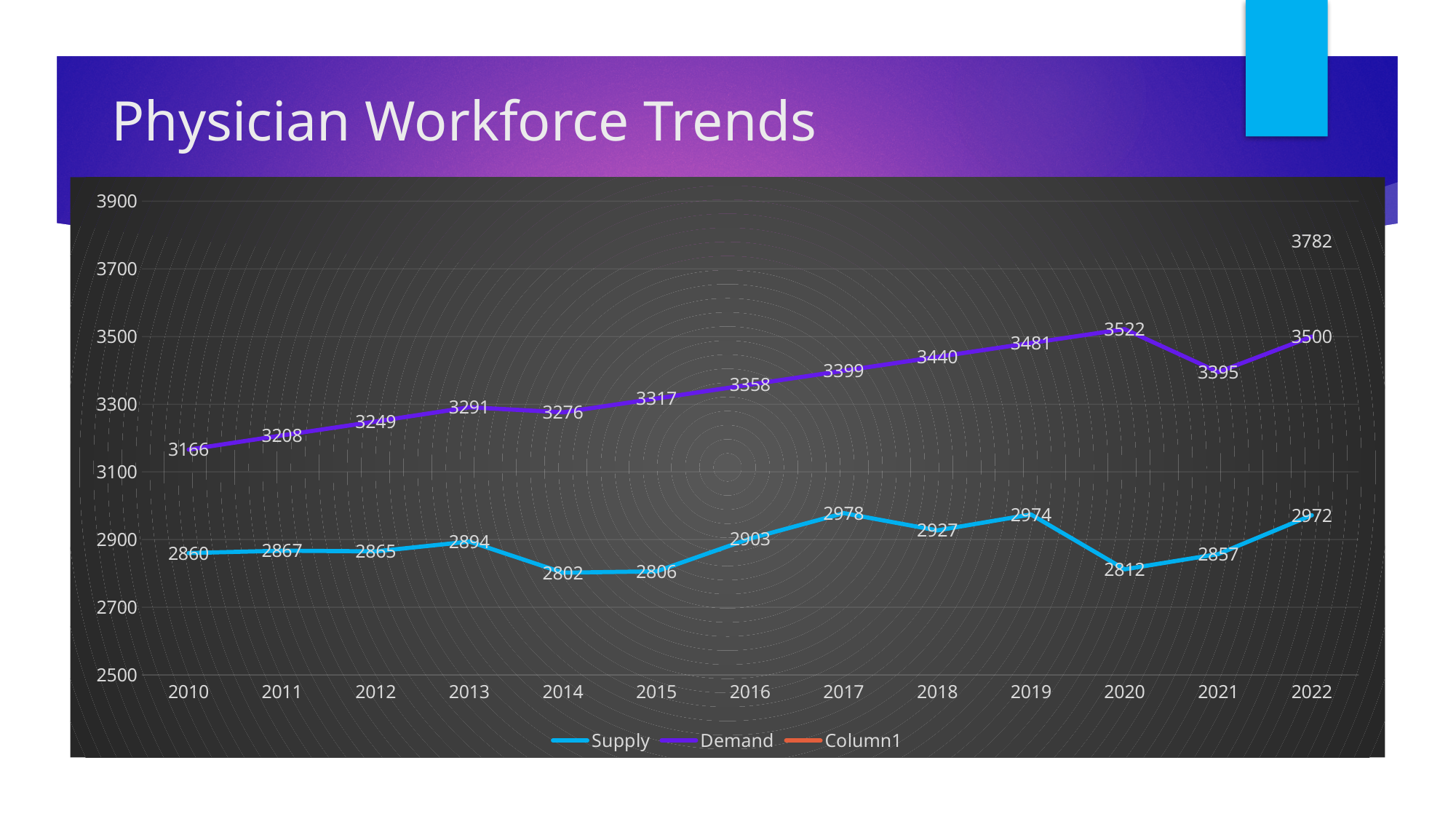
What is the difference between Demand and Supply in 2022? 528 What is the Supply value for 2017? 2978 Which is larger, the Supply value for 2016 or the Supply value for 2018? 2018 Is the Demand value for 2019 greater or less than 3300? greater What is the Demand value for 2021? 3395 What is the Demand value for 2014? 3276 How many years are shown on the x axis? 13 What kind of chart is shown on the slide? Line chart In which year is the Supply series at its lowest? 2014 What is the difference between the Supply values for 2019 and 2020? 162 How many series does the legend list? 3 In which year is the Demand series at its highest? 2020